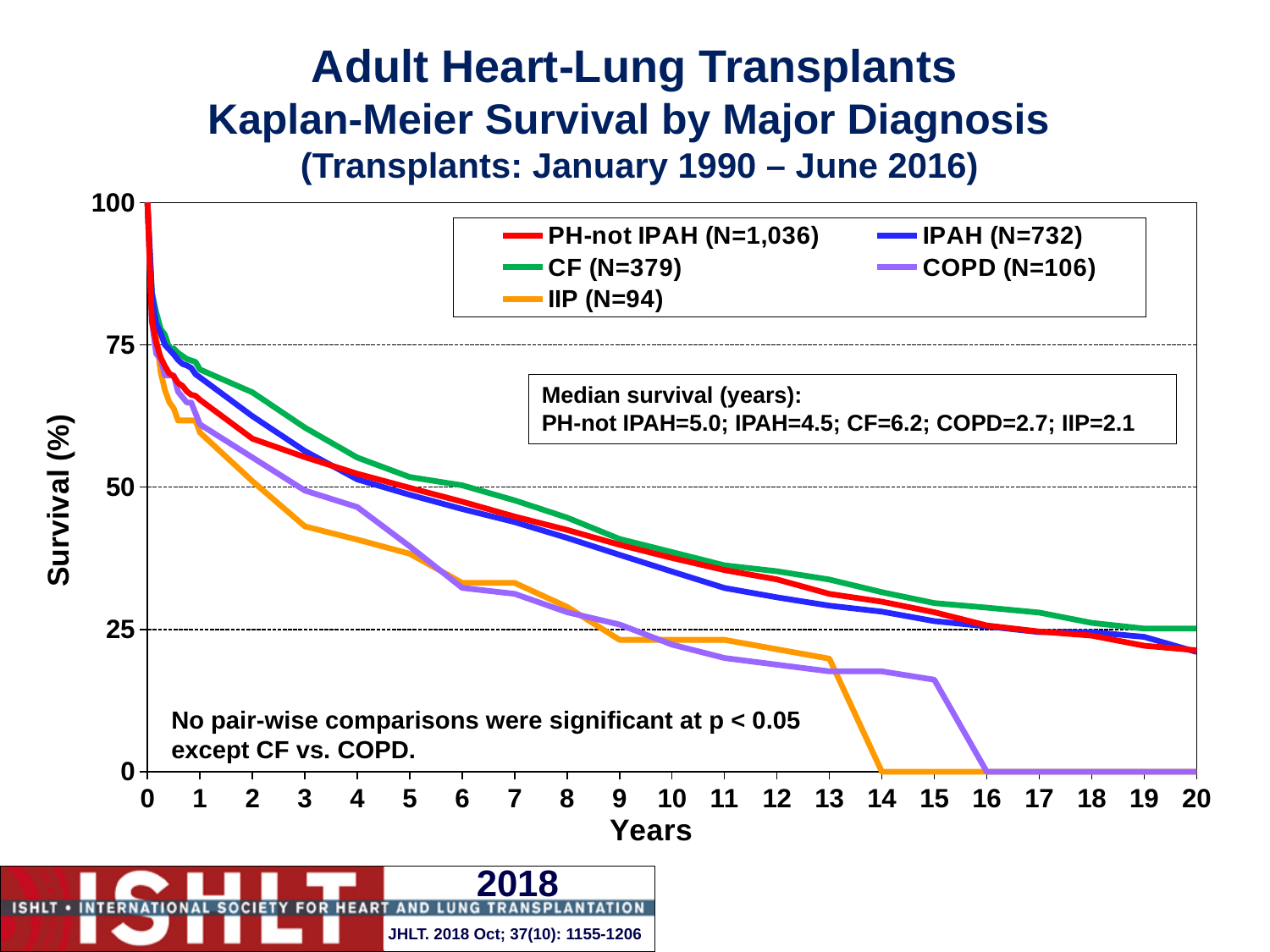
Which diagnosis group has the lowest median survival? IIP Which diagnosis group has the highest median survival? CF How many series does the legend list? 5 What is the median survival in years for IIP according to the text box? 2.1 Is the survival value for IIP at 5 years greater or less than 50? less Is the survival value for CF at 1 year greater or less than 50? greater What is the N for the COPD group shown in the legend? 106 Which has the larger median survival, PH-not IPAH or IPAH? PH-not IPAH What is the difference in median survival (years) between CF and COPD? 3.5 Do the survival curves rise or fall as years increase? fall What kind of chart is shown on the slide? line chart What is the median survival in years for CF according to the text box? 6.2